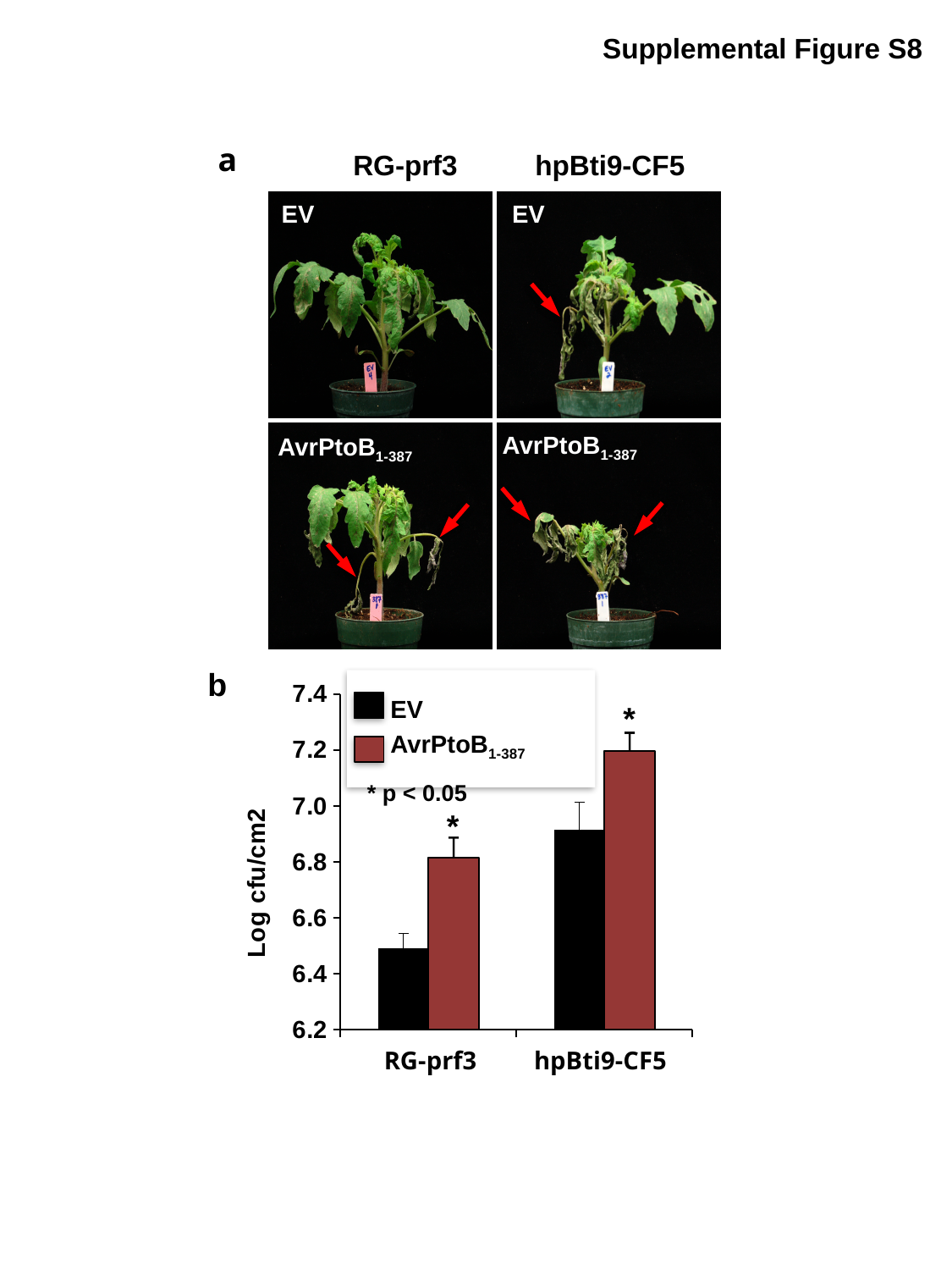
In the bar chart in panel b, is the AvrPtoB1-387 value for RG-prf3 greater or less than 6.6? greater In the bar chart in panel b, is the EV value for RG-prf3 greater or less than 6.6? less What kind of chart is shown in panel b? bar chart In the bar chart in panel b, which bar is the highest? AvrPtoB1-387 for hpBti9-CF5 How many series does the legend of the bar chart in panel b list? 2 How many categories are shown on the x axis of the bar chart in panel b? 2 In the bar chart in panel b, which bar is the lowest? EV for RG-prf3 What is the y-axis label of the bar chart in panel b? Log cfu/cm2 In the bar chart in panel b, is the AvrPtoB1-387 value for hpBti9-CF5 greater or less than 7.0? greater What significance threshold is noted by the asterisk in the bar chart in panel b? p < 0.05 In the bar chart in panel b, for hpBti9-CF5, which is larger: EV or AvrPtoB1-387? AvrPtoB1-387 In the bar chart in panel b, for RG-prf3, which is larger: EV or AvrPtoB1-387? AvrPtoB1-387